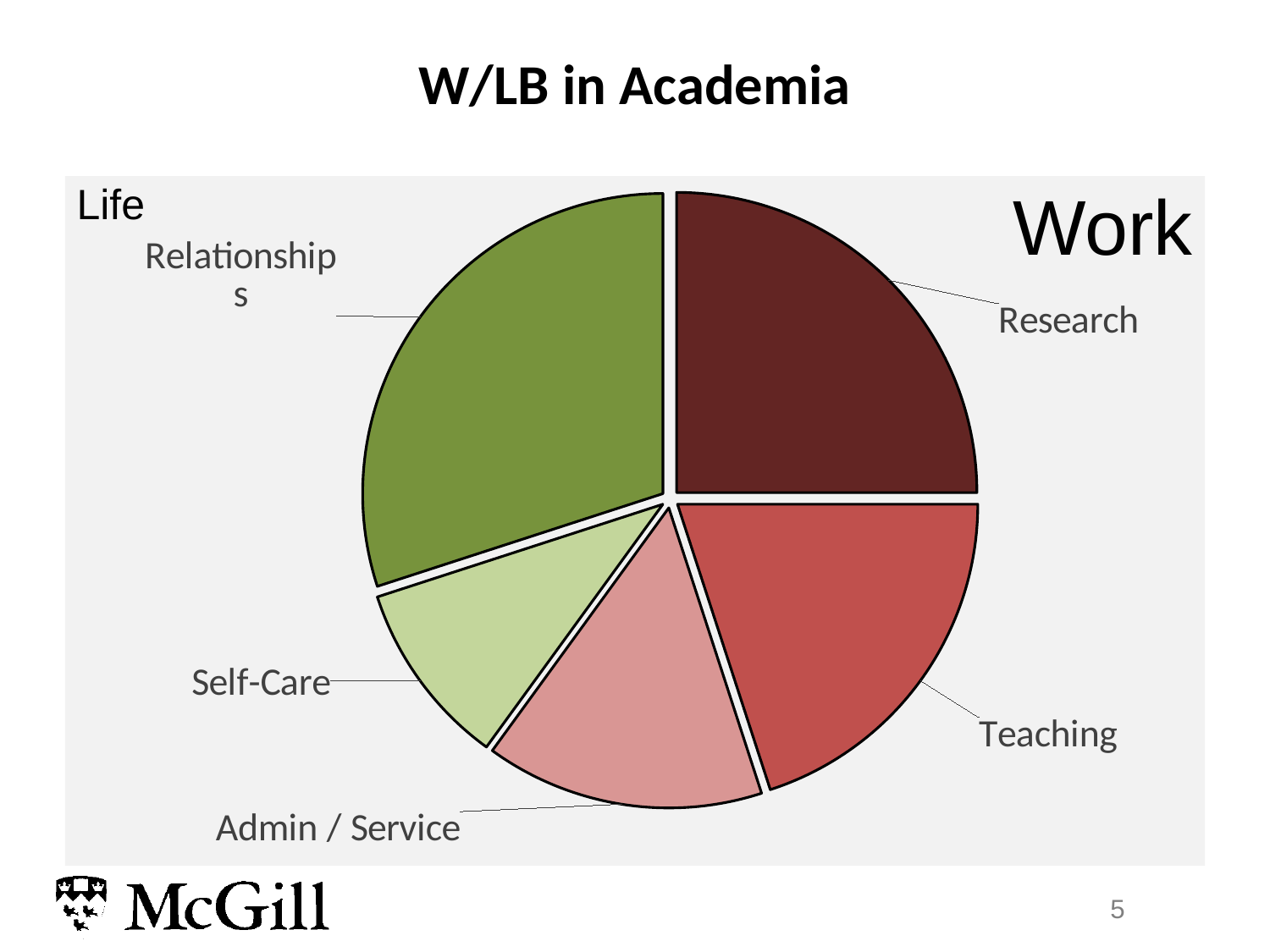
Which slice is larger, Research or Admin / Service? Research How many slices does the pie chart have? 5 What kind of chart is shown on the slide? pie chart Which slice is larger, Teaching or Self-Care? Teaching What is the title of the slide containing the pie chart? W/LB in Academia Which slice is larger, Relationships or Self-Care? Relationships Which slice of the pie chart is the smallest? Self-Care Which slice of the pie chart is the largest? Relationships Which slices of the pie chart are coloured in shades of green? Relationships and Self-Care